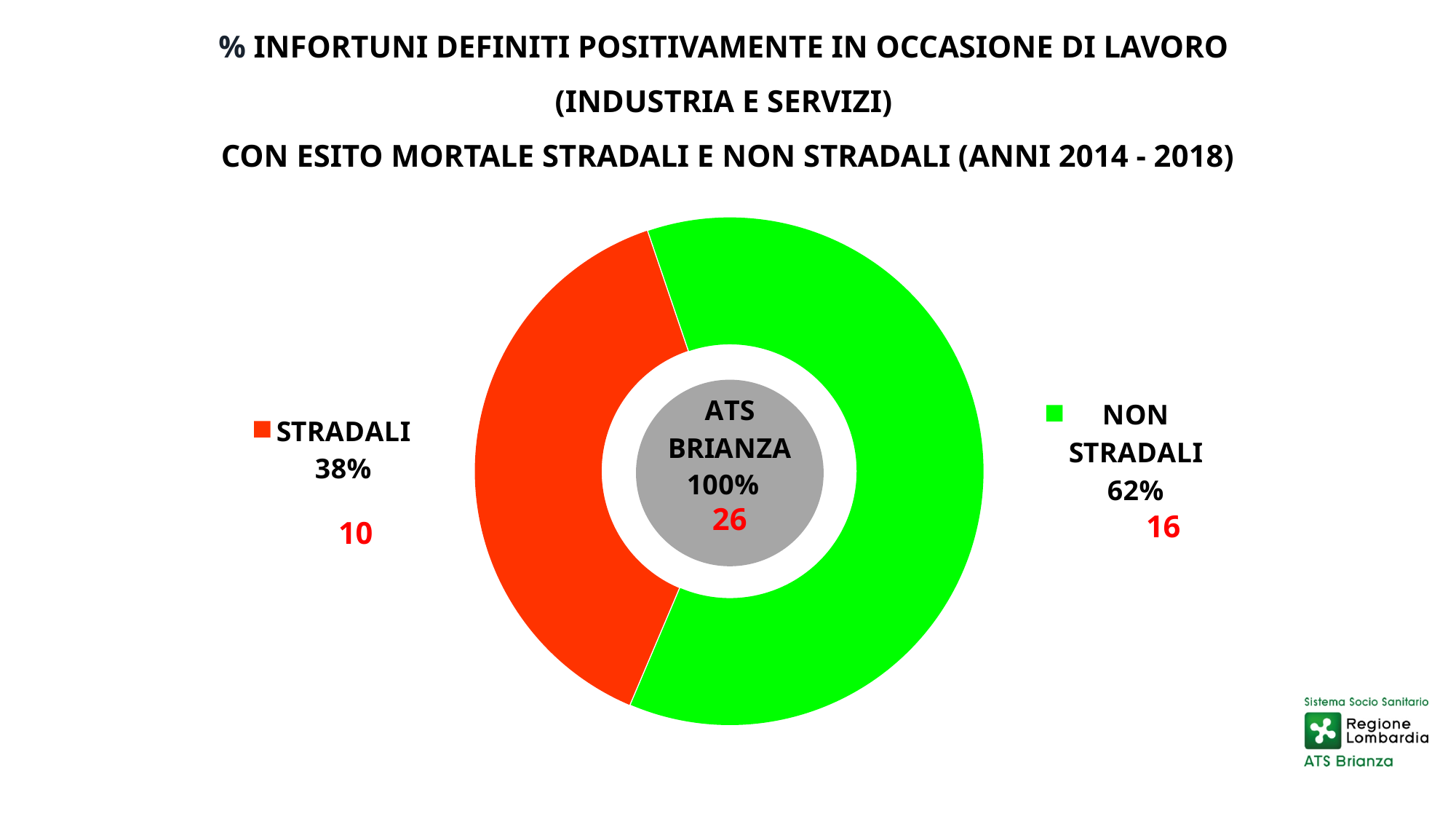
Which category has the smallest share? STRADALI What total is shown in the centre of the chart for ATS BRIANZA? 26 What percentage share does the STRADALI slice have? 38% What colour is the NON STRADALI slice? Green What kind of chart is shown on the slide? Pie chart (doughnut) What is the difference between the counts for NON STRADALI and STRADALI? 6 Which category has the larger share, STRADALI or NON STRADALI? NON STRADALI How many categories are shown in the chart? 2 What is the count shown for STRADALI? 10 What is the count shown for NON STRADALI? 16 What is the difference in percentage points between NON STRADALI and STRADALI? 24% What percentage share does the NON STRADALI slice have? 62%